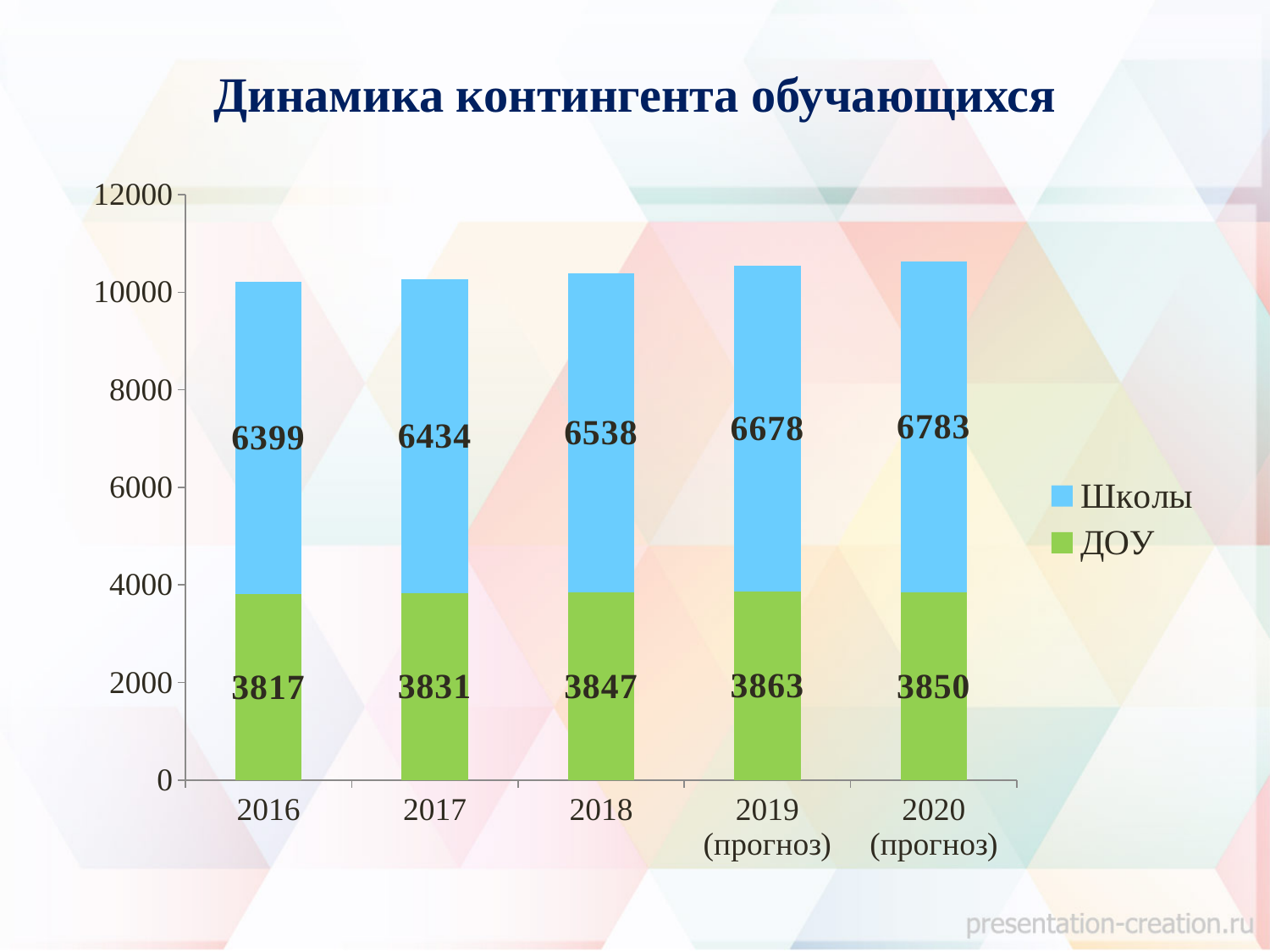
What is the value for Школы in 2020 (прогноз)? 6783 What is the difference between the Школы values for 2020 (прогноз) and 2016? 384 In which year is the ДОУ value lowest? 2016 What kind of chart is shown on the slide? Stacked bar chart What is the total of the stacked bar for 2018? 10385 What is the value for ДОУ in 2019 (прогноз)? 3863 Which is larger: the ДОУ value for 2019 (прогноз) or for 2020 (прогноз)? 2019 (прогноз) How many series does the legend list? 2 Do the Школы values rise or fall from 2016 to 2020 (прогноз)? Rise In which year is the Школы value highest? 2020 (прогноз) What is the value for Школы in 2016? 6399 How many years are shown on the x axis? 5